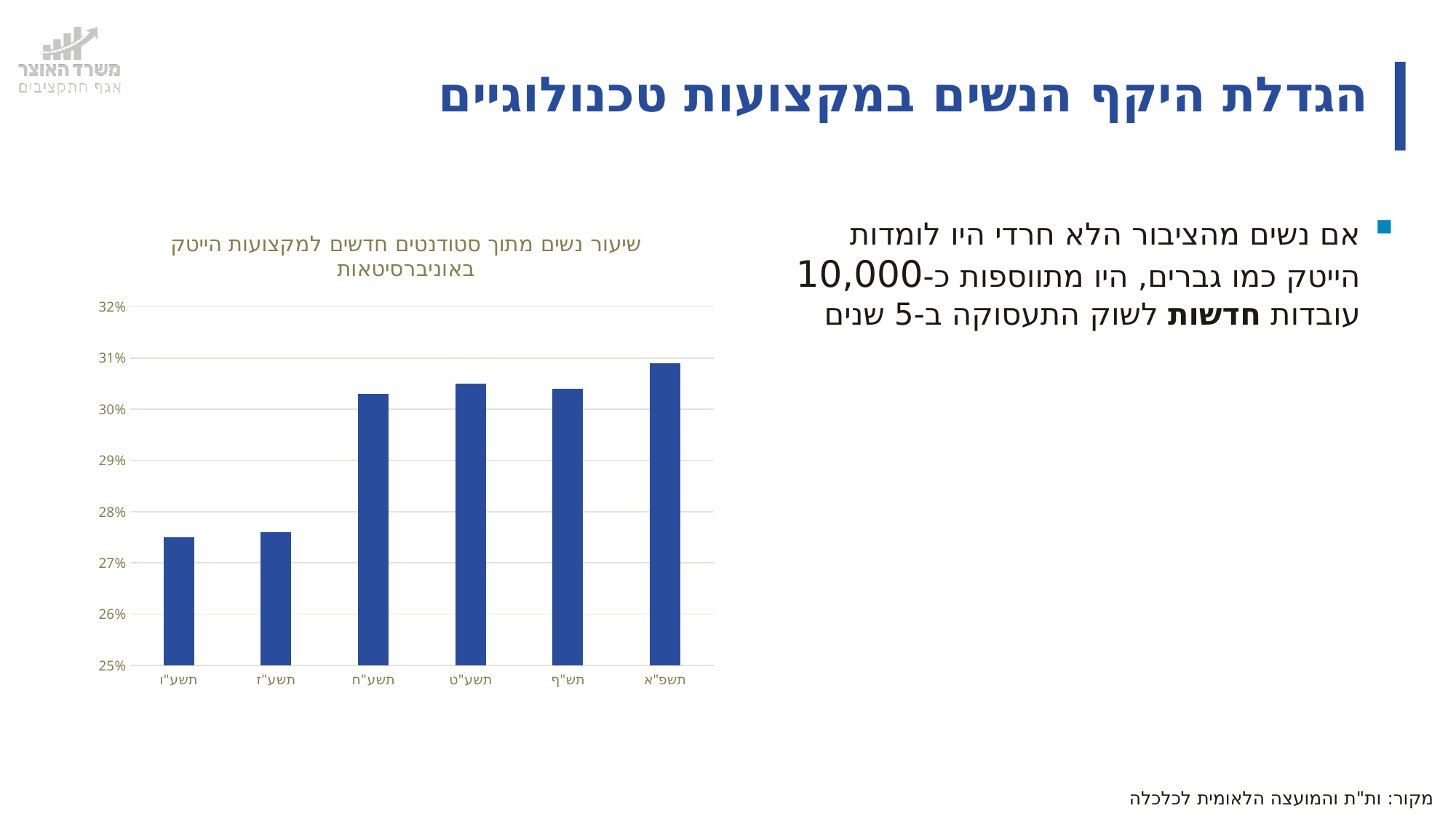
Which year has the highest value in the chart? תשפ"א What is the title of the chart? שיעור נשים מתוך סטודנטים חדשים למקצועות הייטק באוניברסיטאות Do the values generally rise or fall from תשע"ו to תשפ"א? rise Is the value for תשע"ו greater or less than 28%? less What colour are the bars in the chart? blue Is the value for תש"ף greater or less than 29%? greater What kind of chart is shown on the slide? bar chart Is the value for תשע"ח greater or less than 30%? greater Which is larger, the value for תשע"ח or the value for תשע"ו? תשע"ח How many categories (years) are shown on the x axis of the chart? 6